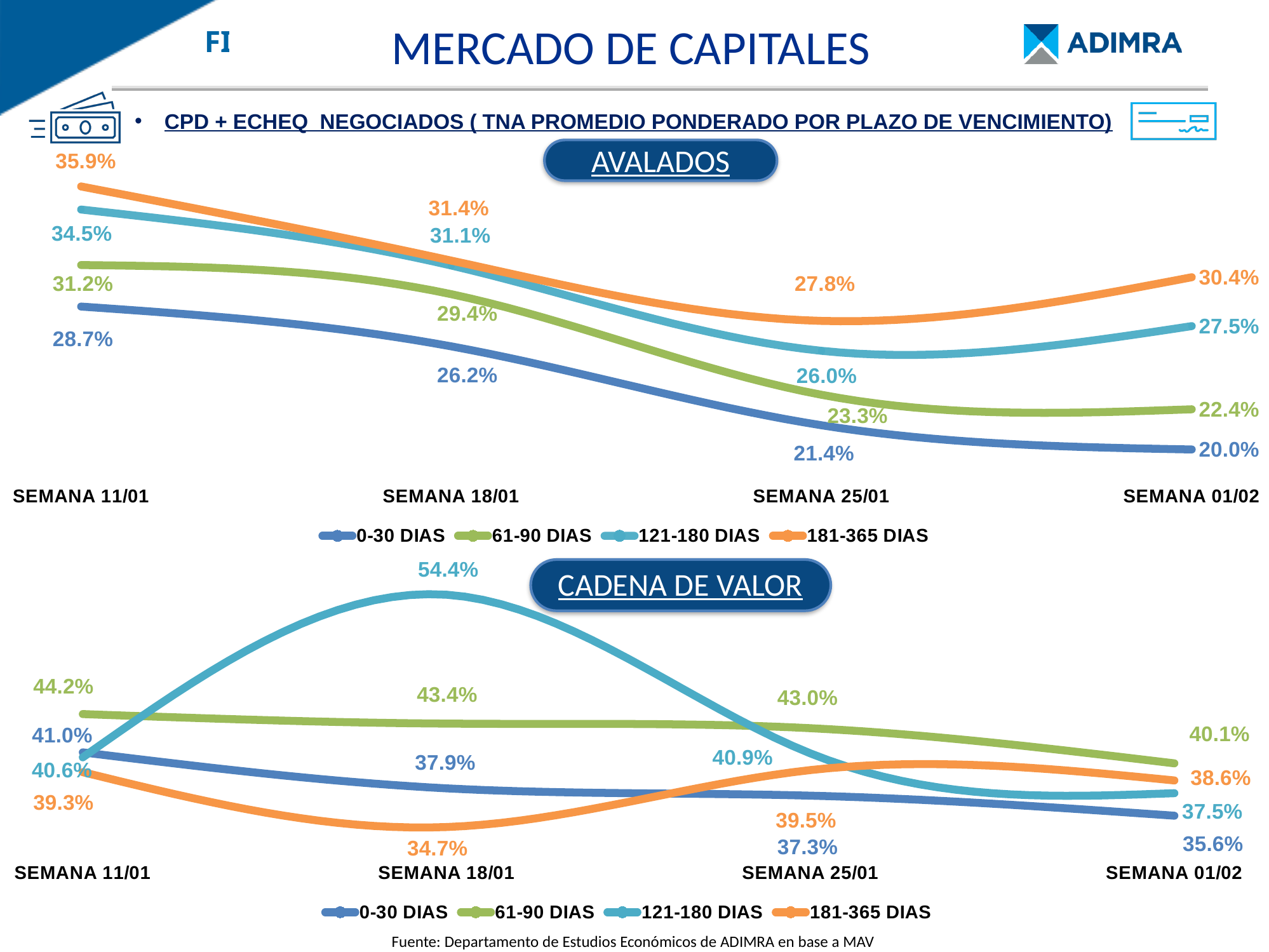
In the CADENA DE VALOR chart, which series has the highest value at SEMANA 18/01? 121-180 DIAS In the AVALADOS chart, what is the difference between 181-365 DIAS and 0-30 DIAS at SEMANA 18/01? 5.2% In the AVALADOS chart, what is the value for 0-30 DIAS at SEMANA 01/02? 20.0% In the CADENA DE VALOR chart, which is larger at SEMANA 01/02: 61-90 DIAS or 0-30 DIAS? 61-90 DIAS In the AVALADOS chart, does the 61-90 DIAS series rise or fall from SEMANA 11/01 to SEMANA 01/02? fall In the CADENA DE VALOR chart, what is the value for 181-365 DIAS at SEMANA 18/01? 34.7% In the AVALADOS chart, what is the value for 181-365 DIAS at SEMANA 11/01? 35.9% How many series does the legend of the AVALADOS chart list? 4 In the CADENA DE VALOR chart, what is the value for 121-180 DIAS at SEMANA 18/01? 54.4% In the AVALADOS chart, which series has the lowest value at SEMANA 25/01? 0-30 DIAS In the CADENA DE VALOR chart, what is the difference between 61-90 DIAS at SEMANA 11/01 and at SEMANA 01/02? 4.1% What type of chart is the CADENA DE VALOR chart? line chart